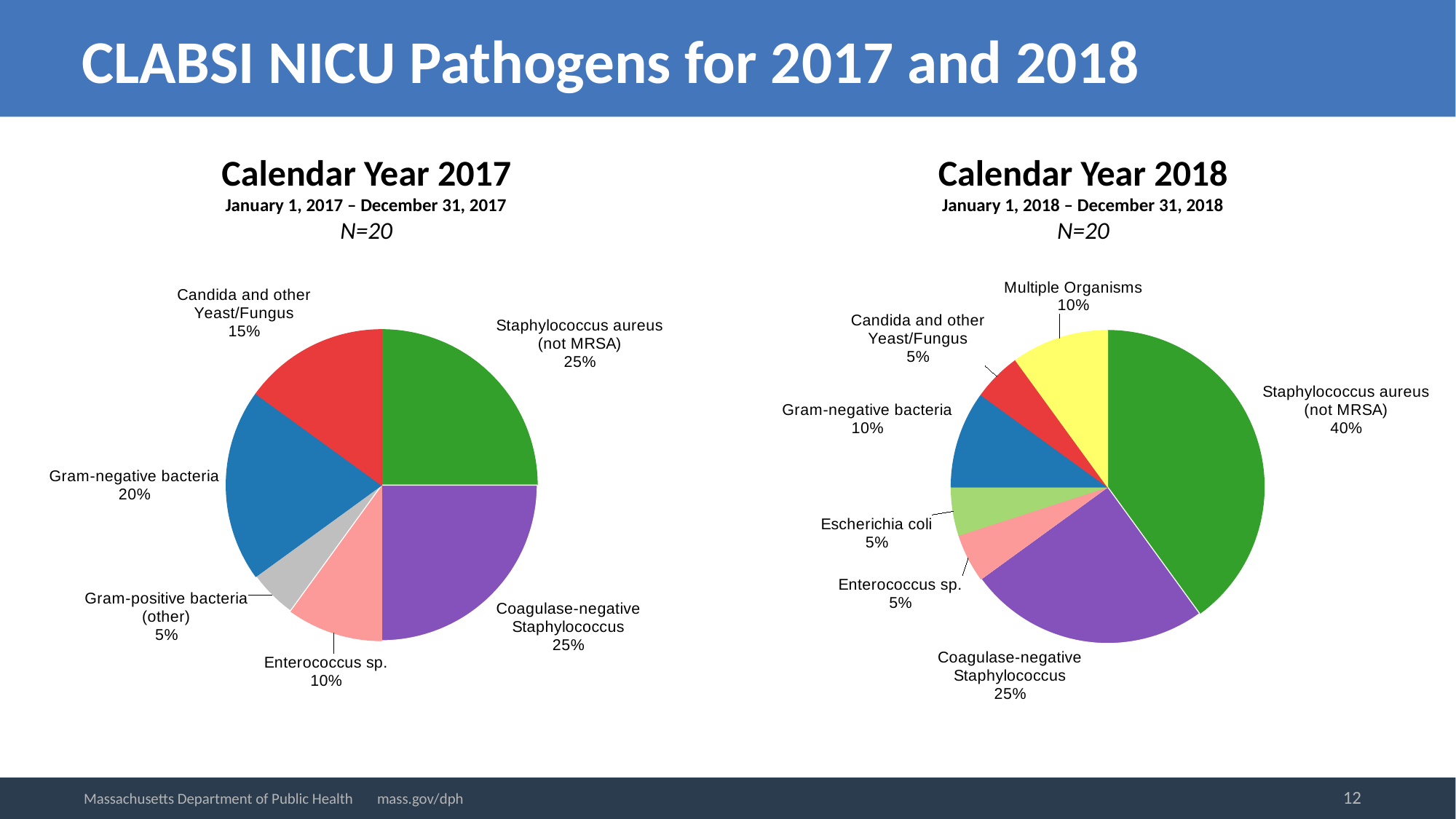
In the Calendar Year 2017 chart, what share does Gram-negative bacteria have? 20% In the Calendar Year 2018 chart, what share does Multiple Organisms have? 10% How many pathogen categories are shown in the Calendar Year 2018 chart? 7 What kind of chart is used for Calendar Year 2017? Pie chart How many pathogen categories are shown in the Calendar Year 2017 chart? 6 In the Calendar Year 2018 chart, which pathogen category has the largest slice? Staphylococcus aureus (not MRSA) In the Calendar Year 2018 chart, which is larger: the share for Gram-negative bacteria or the share for Escherichia coli? Gram-negative bacteria In the Calendar Year 2018 chart, what share does Staphylococcus aureus (not MRSA) have? 40% What is the N value shown for the Calendar Year 2018 chart? N=20 In the Calendar Year 2017 chart, which pathogen category has the smallest slice? Gram-positive bacteria (other) In the Calendar Year 2017 chart, what is the difference between the shares for Gram-negative bacteria and Enterococcus sp.? 10% In the Calendar Year 2017 chart, what share does Candida and other Yeast/Fungus have? 15%